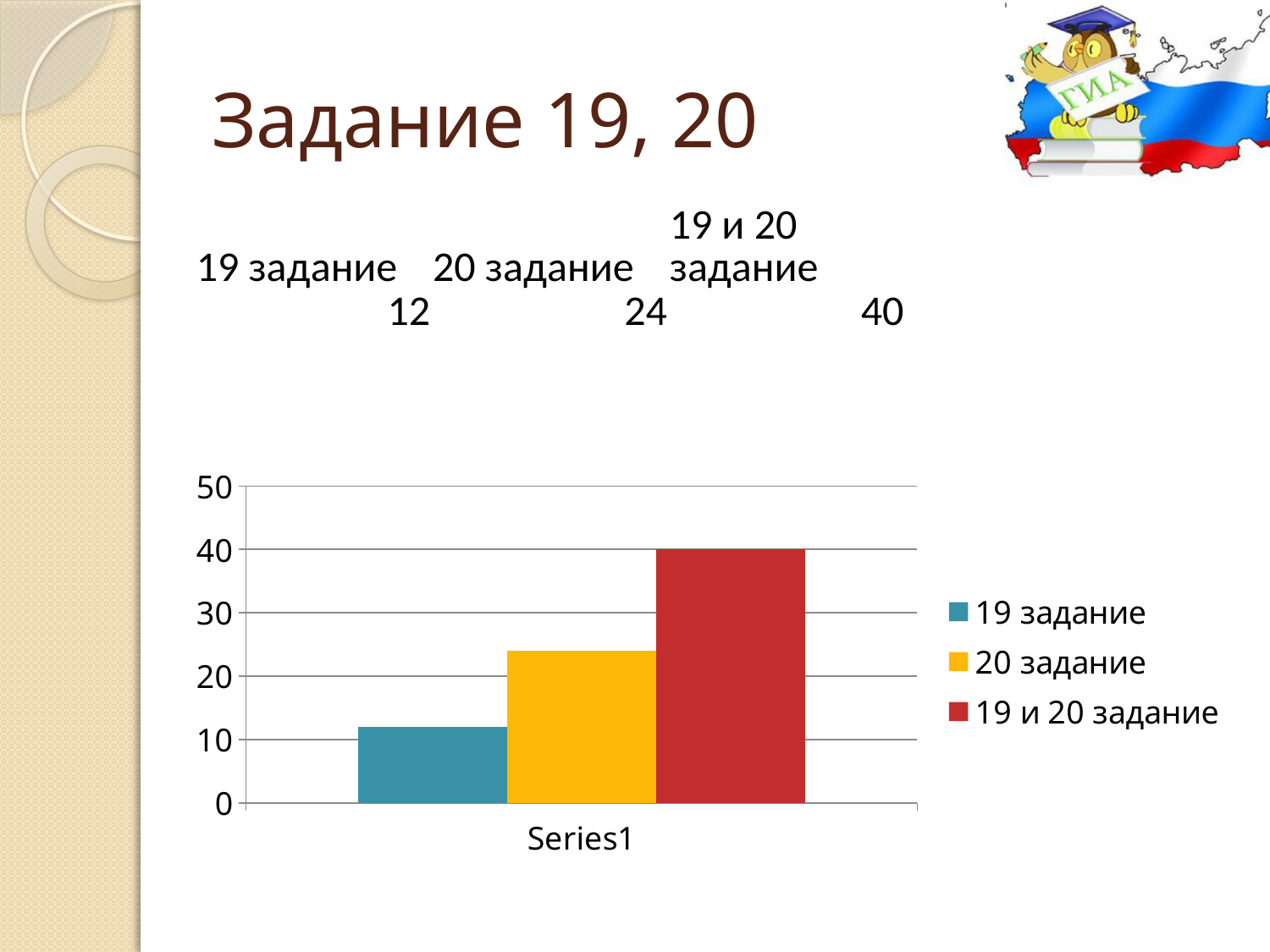
Which series has the highest value? 19 и 20 задание How many series does the legend list? 3 What is the value for 19 и 20 задание? 40 Which is larger, the value for 20 задание or the value for 19 задание? 20 задание What kind of chart is shown on the slide? bar chart What is the value for 20 задание? 24 What is the difference between the values for 19 и 20 задание and 20 задание? 16 What is the label on the x axis under the bars? Series1 Which series has the lowest value? 19 задание Is the value for 20 задание greater or less than 30? less What is the difference between the values for 20 задание and 19 задание? 12 What is the value for 19 задание? 12